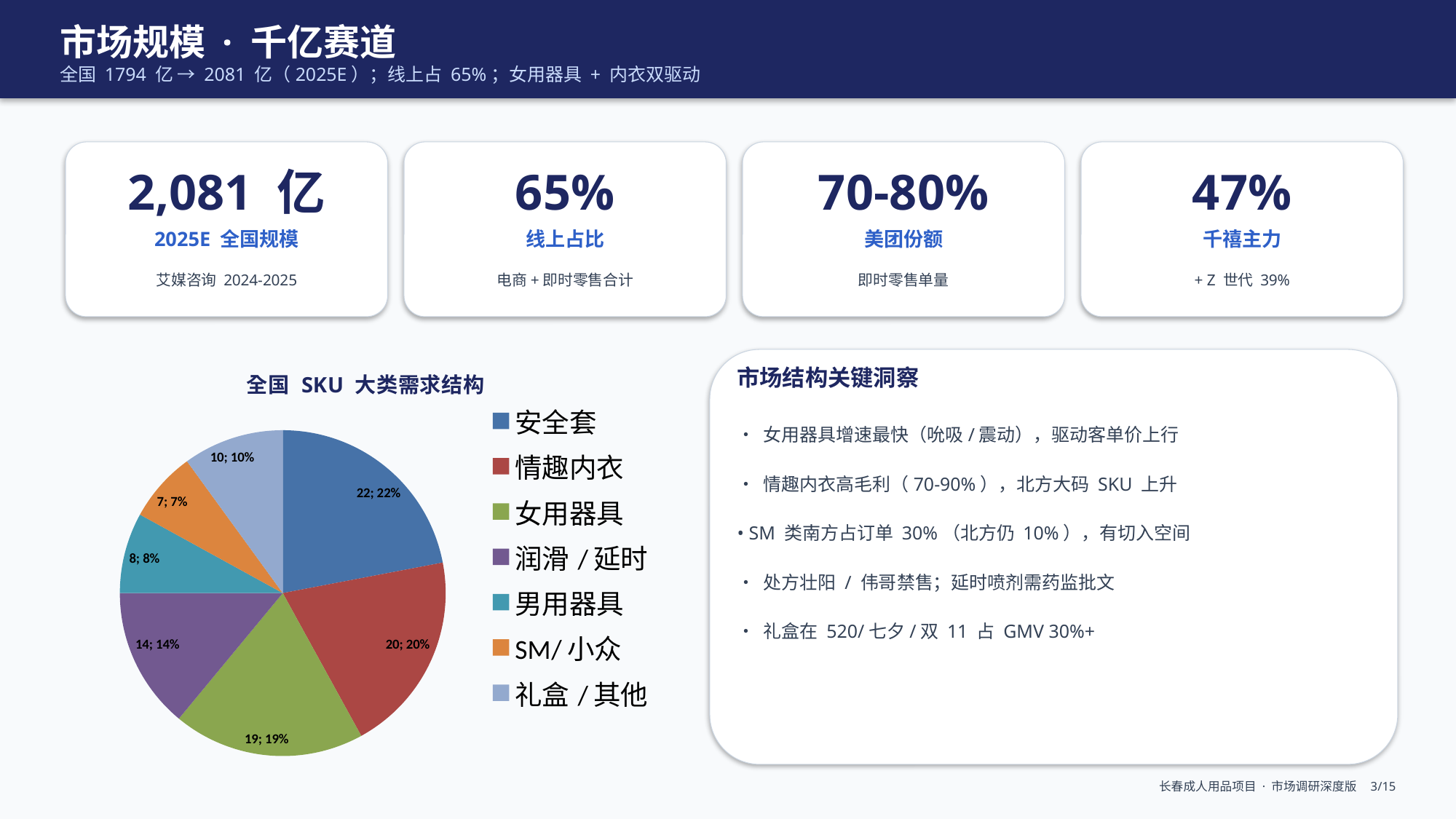
In the pie chart 全国 SKU 大类需求结构, what percentage share does 润滑 / 延时 have? 14% What kind of chart is shown under the title 全国 SKU 大类需求结构? pie chart In the pie chart 全国 SKU 大类需求结构, what is the difference in percentage points between 情趣内衣 and 男用器具? 12 In the pie chart 全国 SKU 大类需求结构, what percentage share does 安全套 have? 22% Which category has the smallest slice in the pie chart 全国 SKU 大类需求结构? SM/ 小众 Which category has the largest slice in the pie chart 全国 SKU 大类需求结构? 安全套 How many entries does the legend of the pie chart 全国 SKU 大类需求结构 list? 7 In the pie chart 全国 SKU 大类需求结构, what colour is the 情趣内衣 slice? red In the pie chart 全国 SKU 大类需求结构, which is larger, 润滑 / 延时 or 礼盒 / 其他? 润滑 / 延时 How many slices does the pie chart 全国 SKU 大类需求结构 have? 7 In the pie chart 全国 SKU 大类需求结构, what percentage share does 女用器具 have? 19% In the pie chart 全国 SKU 大类需求结构, what percentage share does 礼盒 / 其他 have? 10%